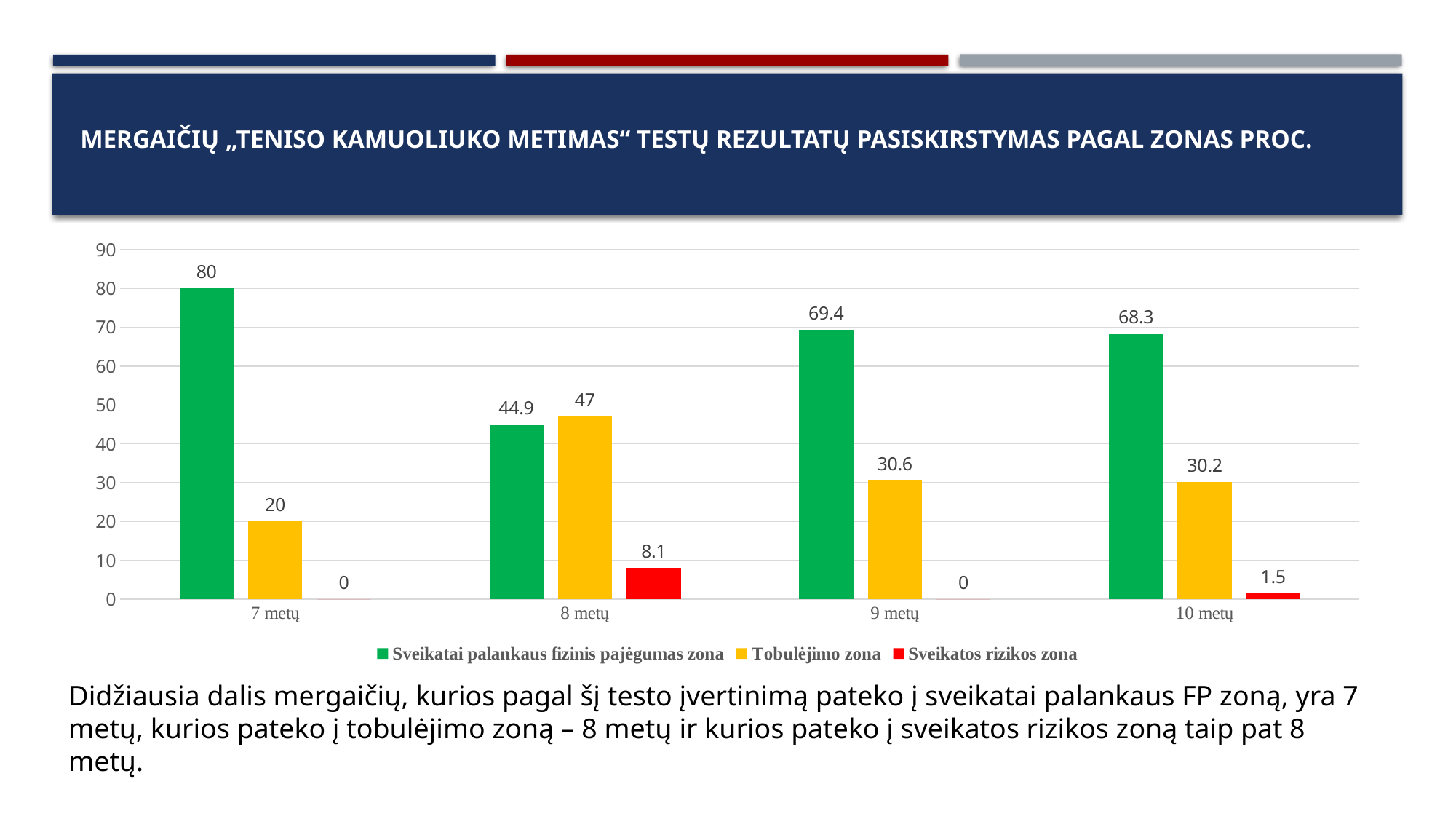
What is the value for 'Sveikatos rizikos zona' at 10 metų? 1.5 Which colour represents 'Sveikatos rizikos zona' in the chart? Red What is the value for 'Sveikatai palankaus fizinis pajėgumas zona' at 7 metų? 80 How many series does the legend list? 3 What kind of chart is shown on the slide? Bar chart Which age group has the lowest value for 'Tobulėjimo zona'? 7 metų What is the value for 'Tobulėjimo zona' at 9 metų? 30.6 Which is larger at 10 metų: 'Sveikatai palankaus fizinis pajėgumas zona' or 'Tobulėjimo zona'? Sveikatai palankaus fizinis pajėgumas zona What is the difference between the 'Sveikatai palankaus fizinis pajėgumas zona' value and the 'Tobulėjimo zona' value at 8 metų? 2.1 What is the value for 'Sveikatos rizikos zona' at 8 metų? 8.1 How many age groups are shown on the x axis? 4 Which age group has the highest value for 'Sveikatai palankaus fizinis pajėgumas zona'? 7 metų